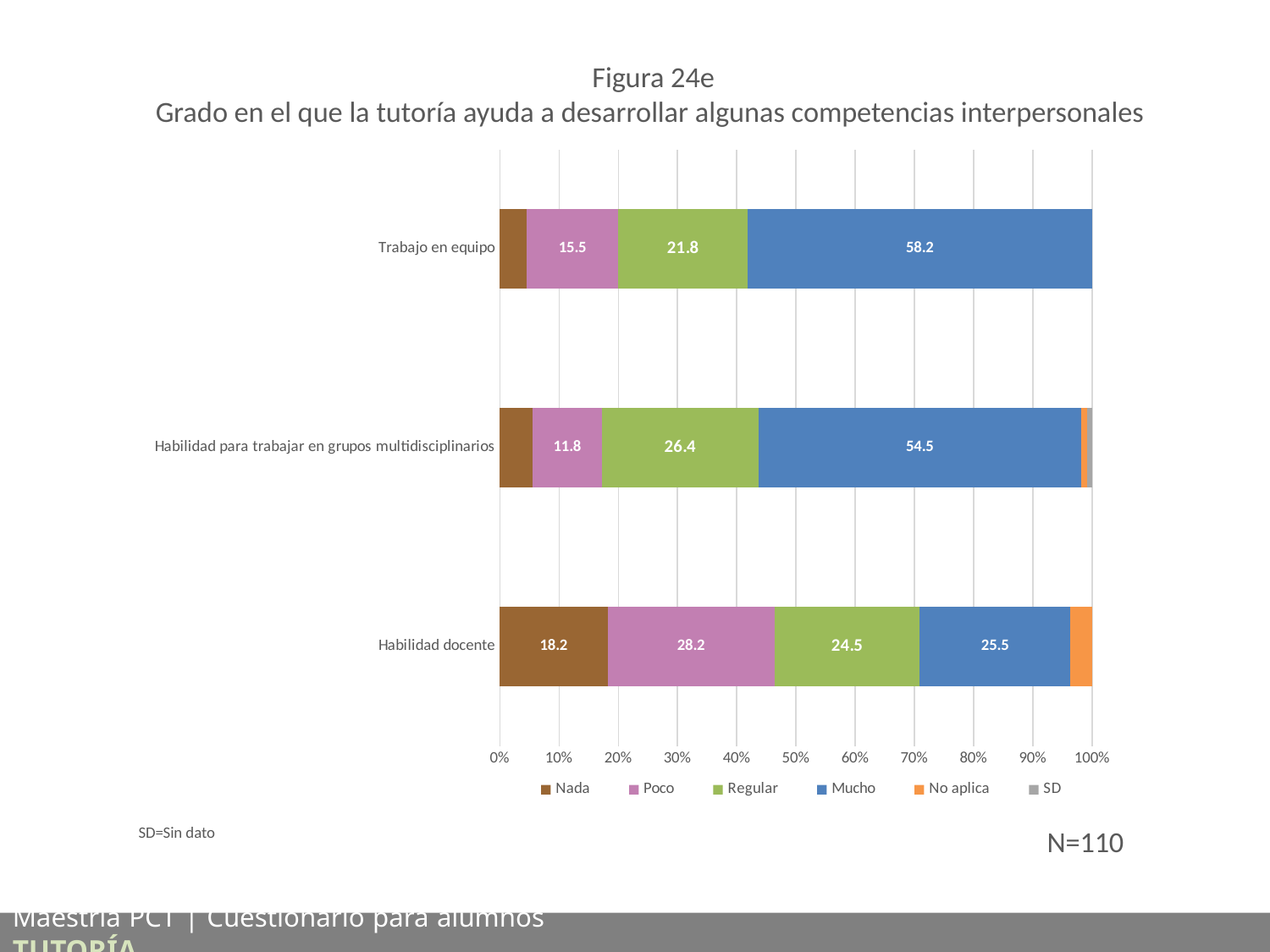
How many categories are shown on the chart? 3 Is the Nada value for Trabajo en equipo greater or less than 10%? less What is the difference between the Poco values for Habilidad docente and Trabajo en equipo? 12.7 What kind of chart is shown on the slide? Stacked bar chart How many series does the legend list? 6 What is the difference between the Mucho values for Trabajo en equipo and Habilidad para trabajar en grupos multidisciplinarios? 3.7 What is the value for Mucho for Trabajo en equipo? 58.2 Which category has the highest value for Mucho? Trabajo en equipo What is the value for Regular for Habilidad para trabajar en grupos multidisciplinarios? 26.4 Which category has the lowest value for Poco? Habilidad para trabajar en grupos multidisciplinarios Which is larger: the Regular value for Habilidad docente or the Regular value for Trabajo en equipo? Habilidad docente What is the value for Nada for Habilidad docente? 18.2